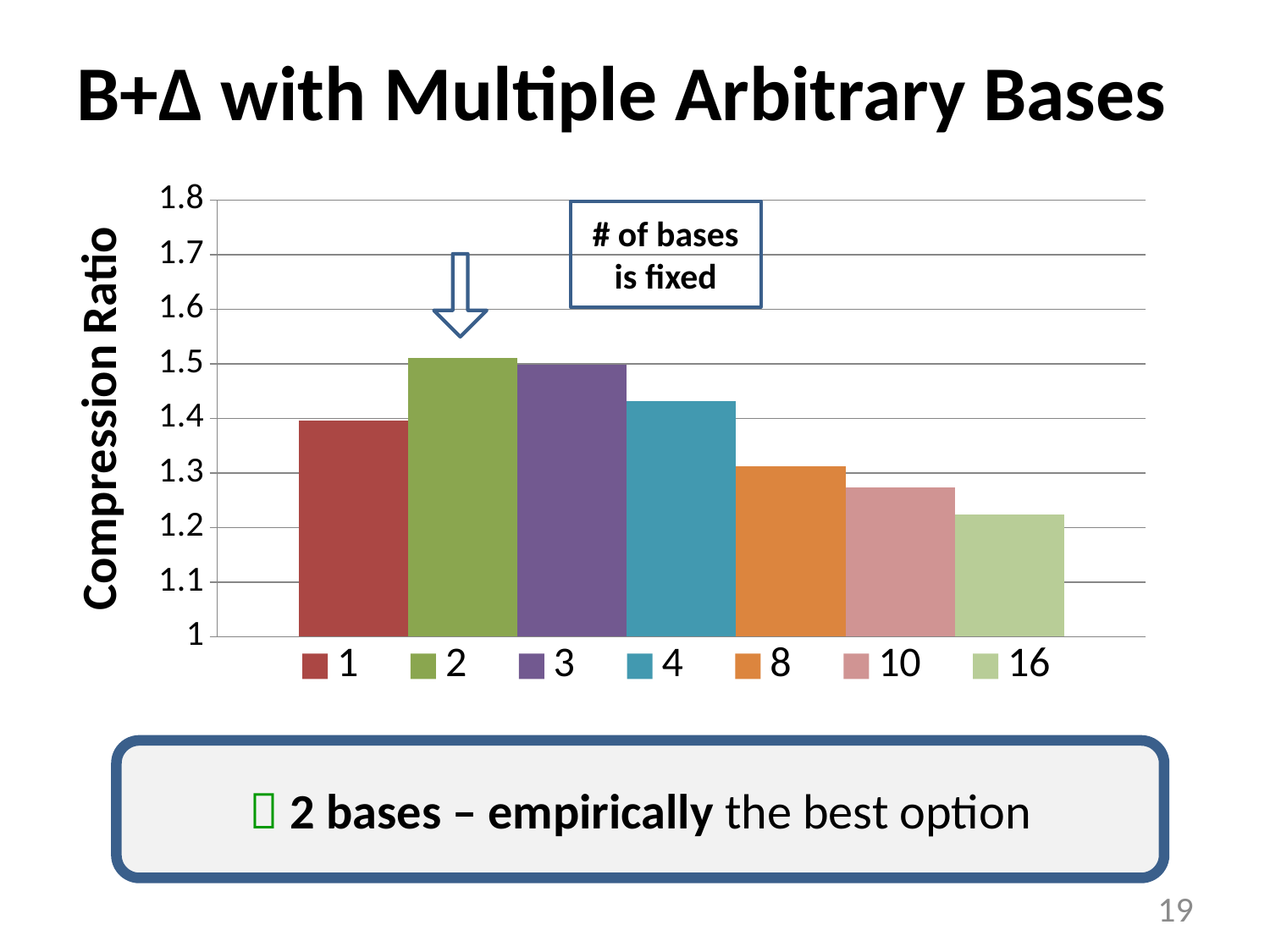
What kind of chart is shown on the slide? bar chart From legend entry 2 through legend entry 16, do the compression ratios rise or fall? fall What does the boxed annotation above the bars say? # of bases is fixed Which legend entry has the highest compression ratio? 2 Which has the larger compression ratio, legend entry 1 or legend entry 8? 1 Is the compression ratio for legend entry 2 greater or less than 1.4? greater Which legend entry has the lowest compression ratio? 16 How many bars are plotted in the chart? 7 Is the compression ratio for legend entry 4 greater or less than 1.5? less How many entries does the chart's legend list? 7 Is the compression ratio for legend entry 10 greater or less than 1.3? less What is the title of the vertical axis? Compression Ratio